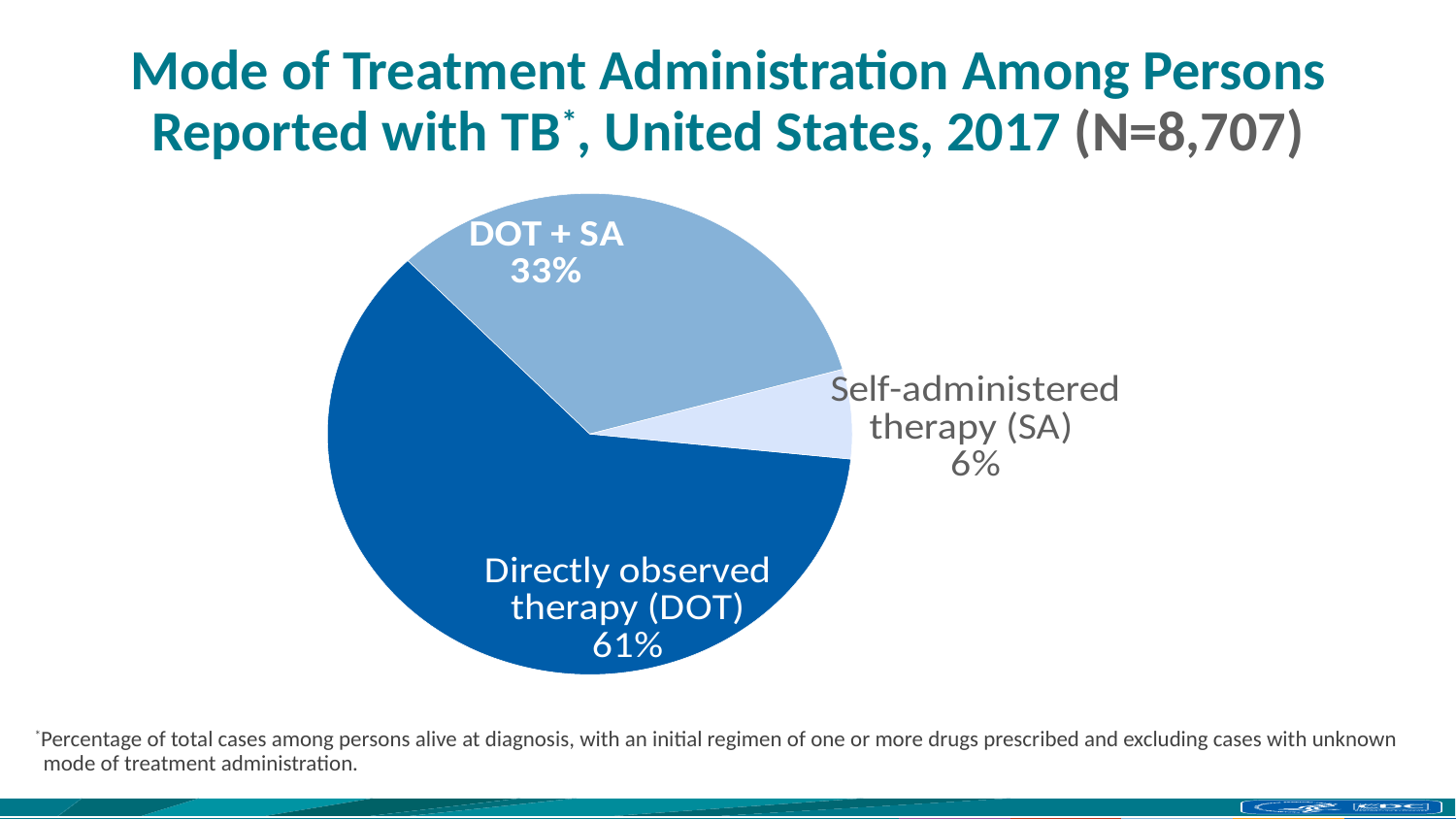
Which is larger, the share for DOT + SA or the share for self-administered therapy (SA)? DOT + SA What is the total number of persons (N) reported in the chart title? 8,707 What percentage of persons received self-administered therapy (SA)? 6% What kind of chart is shown on the slide? Pie chart How many slices does the pie chart have? 3 Which mode of treatment administration has the smallest share? Self-administered therapy (SA) What percentage of persons received directly observed therapy (DOT)? 61% Which mode of treatment administration has the largest share? Directly observed therapy (DOT) What percentage of persons received DOT + SA? 33% What is the difference in percentage points between DOT + SA and self-administered therapy (SA)? 27 Which year does the chart cover? 2017 What is the difference in percentage points between DOT and DOT + SA? 28